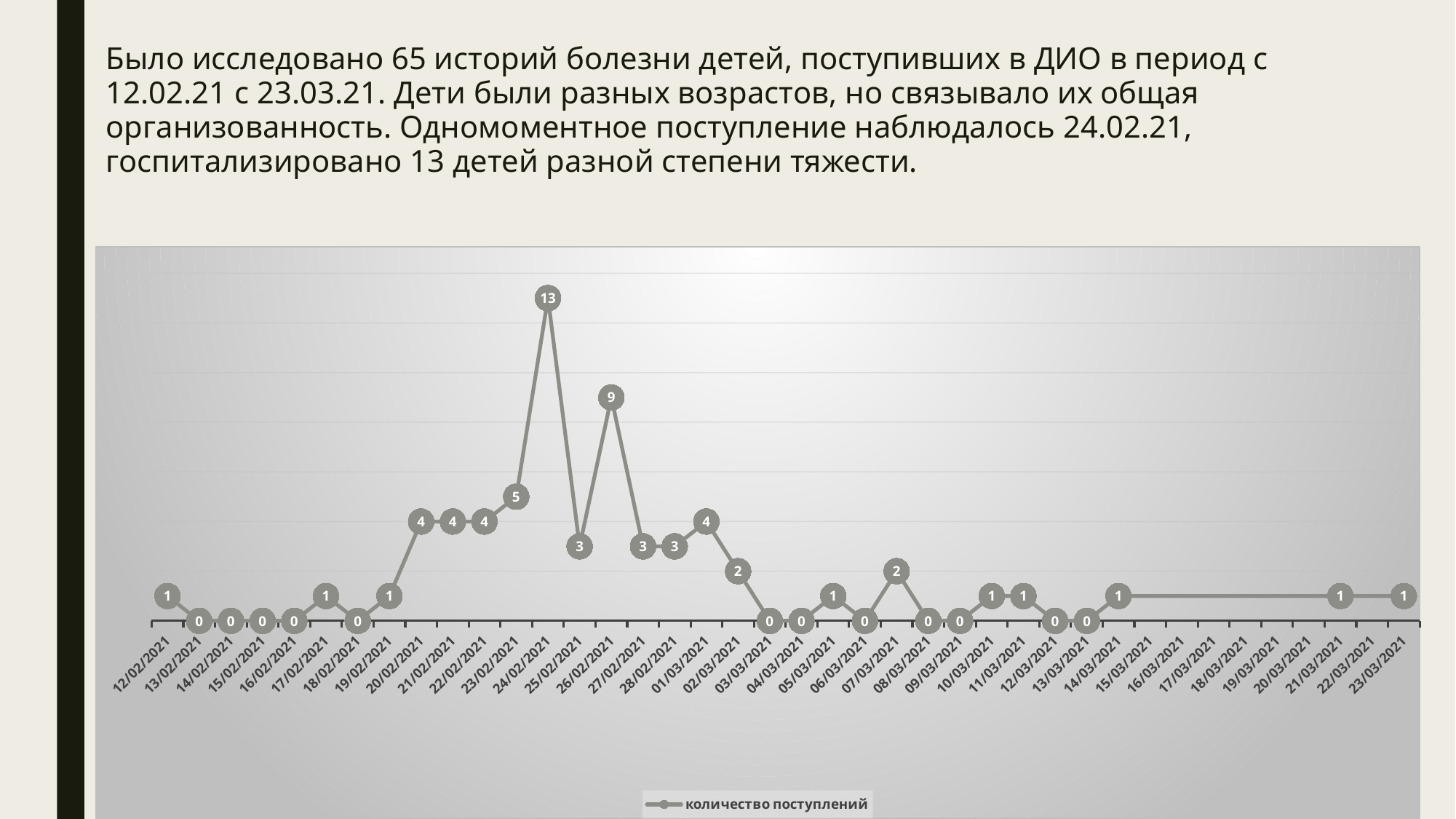
What is the difference between the values for 24/02/2021 and 26/02/2021? 4 How many series does the legend list? 1 What is the value for 26/02/2021? 9 What is the name of the series in the legend? количество поступлений How many dates are shown on the x axis? 40 What is the value for 24/02/2021? 13 What is the value for 01/03/2021? 4 Which has a larger value, 23/02/2021 or 25/02/2021? 23/02/2021 What kind of chart is shown on the slide? Line chart On which date is the number of admissions highest? 24/02/2021 What is the value for 07/03/2021? 2 Do the values rise or fall from 19/02/2021 to 24/02/2021? Rise